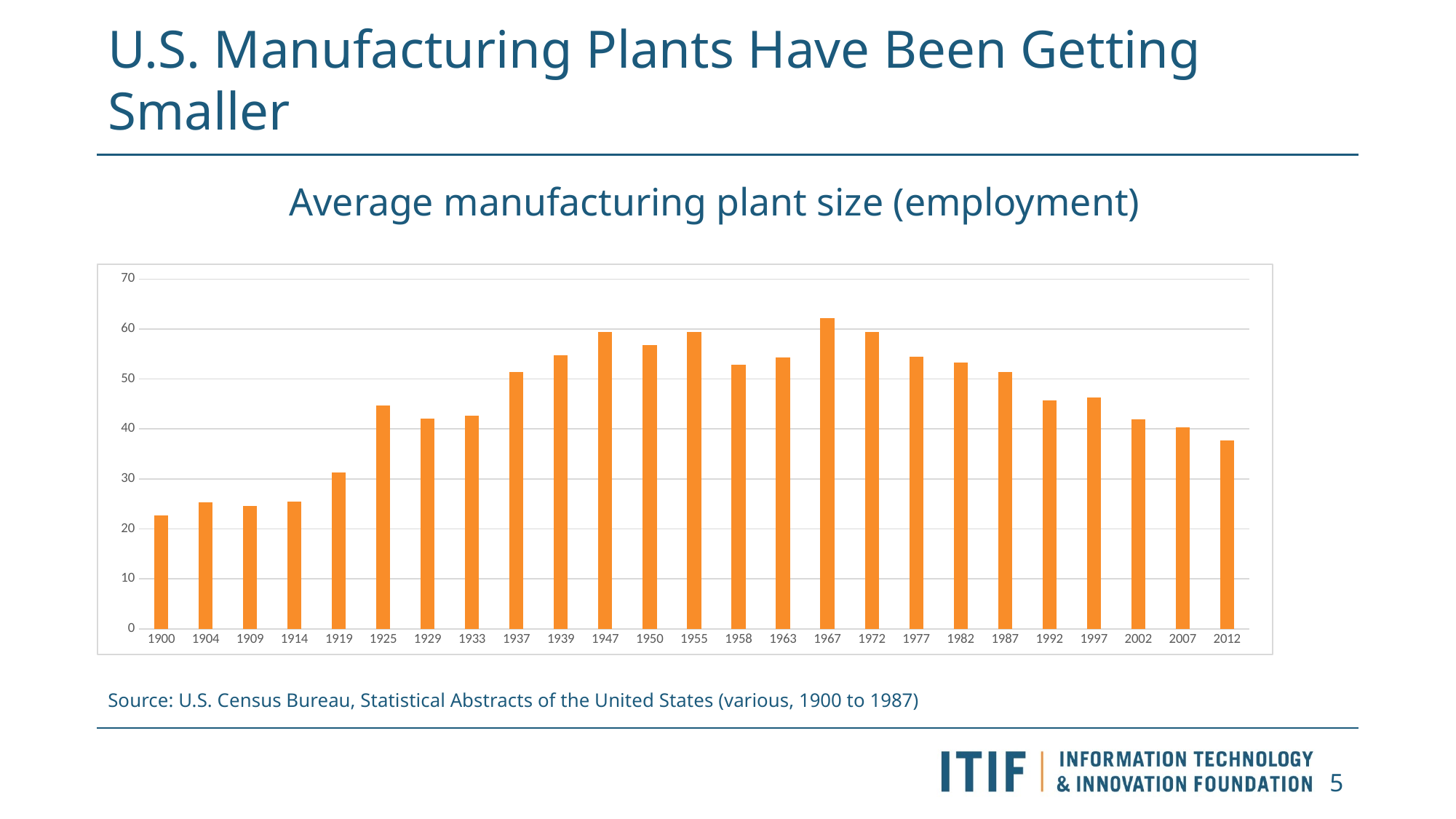
Do the values rise or fall from 1967 to 2012? fall Is the value for 1992 greater or less than 50? less Which year has the highest average manufacturing plant size? 1967 What is the title of the chart? Average manufacturing plant size (employment) How many years are shown on the x axis of the chart? 25 Which is larger, the value for 1919 or the value for 1925? 1925 Is the value for 1919 greater or less than 30? greater What kind of chart is shown on the slide? bar chart Which is larger, the value for 1900 or the value for 2012? 2012 Is the value for 2012 greater or less than 40? less Which year has the lowest average manufacturing plant size? 1900